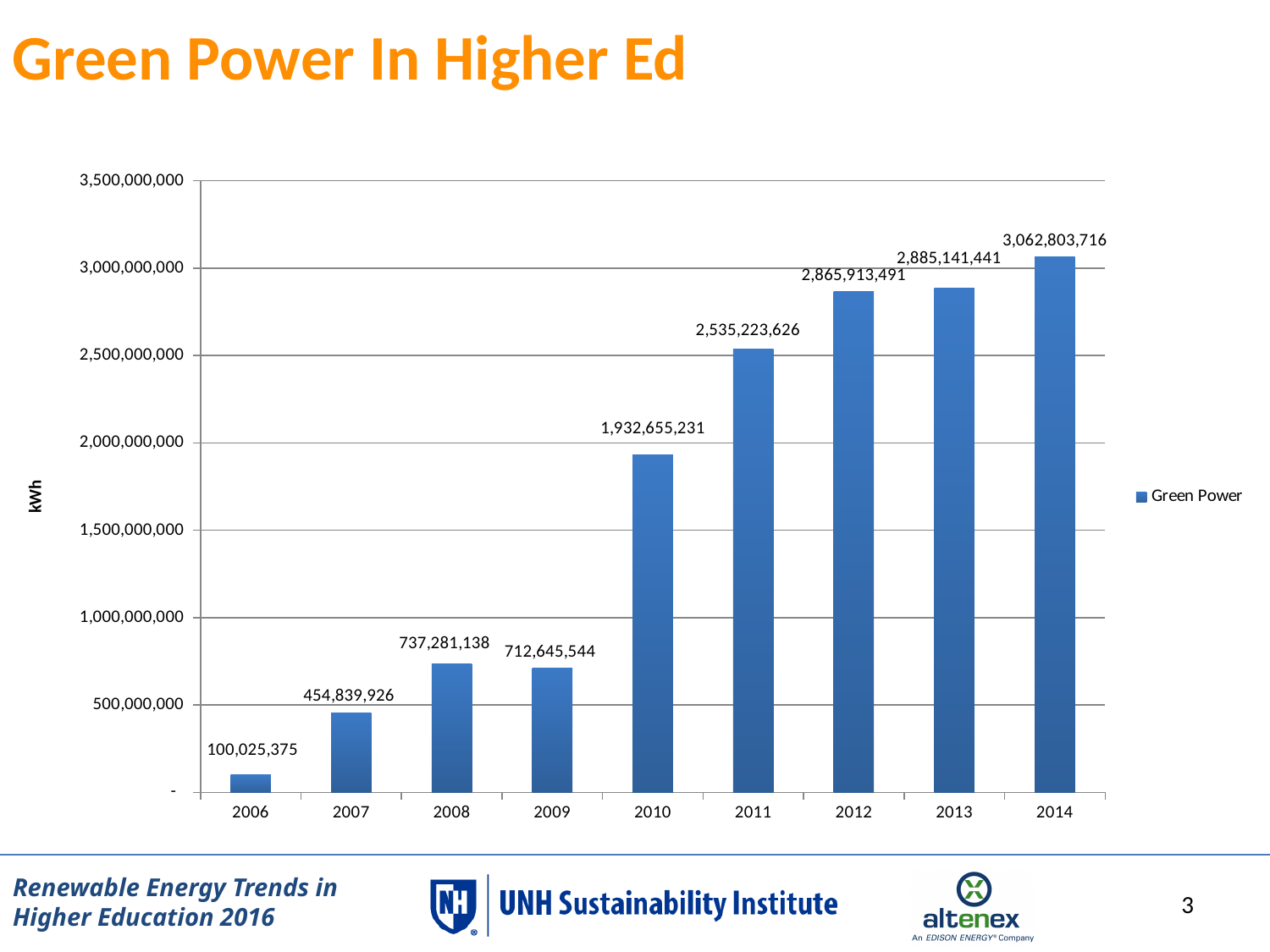
Which year has the larger Green Power value, 2008 or 2009? 2008 What is the Green Power value for 2006? 100,025,375 What is the Green Power value for 2010? 1,932,655,231 What is the difference between the Green Power values for 2014 and 2013? 177,662,275 What is the difference between the Green Power values for 2008 and 2009? 24,635,594 Do the Green Power values generally rise or fall from 2006 to 2014? rise What is the Green Power value for 2012? 2,865,913,491 Is the Green Power value for 2011 greater or less than 2,500,000,000? greater Which year has the highest Green Power value? 2014 Which year has the lowest Green Power value? 2006 What kind of chart is shown on the slide? bar chart How many years are shown on the x axis? 9